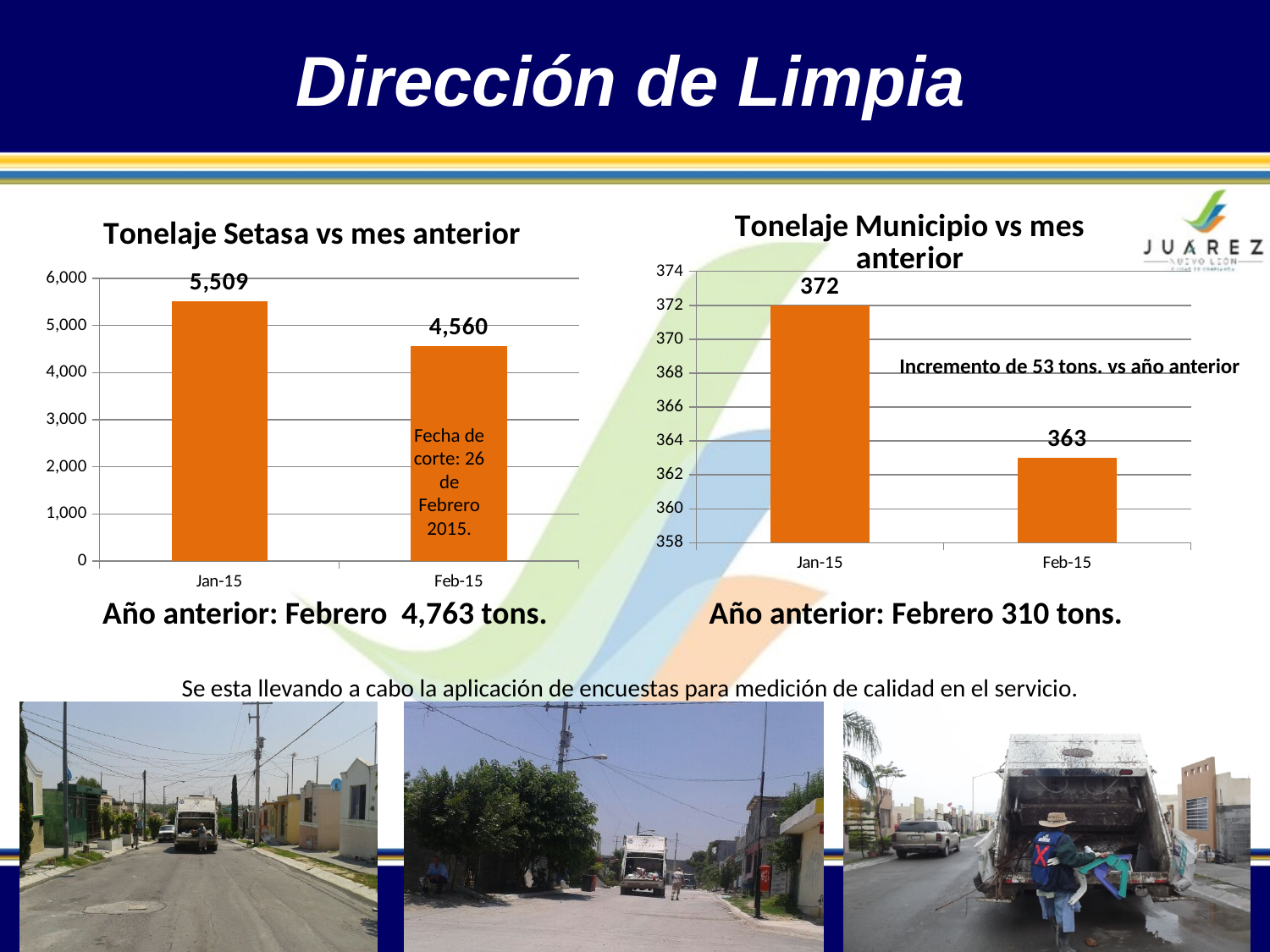
In the 'Tonelaje Municipio vs mes anterior' chart, what is the value for Jan-15? 372 What kind of chart is 'Tonelaje Municipio vs mes anterior'? Bar chart In the 'Tonelaje Municipio vs mes anterior' chart, which month has the lowest value? Feb-15 In the 'Tonelaje Municipio vs mes anterior' chart, what is the difference between the Jan-15 and Feb-15 values? 9 In the 'Tonelaje Setasa vs mes anterior' chart, what is the difference between the Jan-15 and Feb-15 values? 949 In the 'Tonelaje Setasa vs mes anterior' chart, which month has the highest value? Jan-15 How many bars are plotted in the 'Tonelaje Setasa vs mes anterior' chart? 2 In the 'Tonelaje Setasa vs mes anterior' chart, what is the value for Jan-15? 5,509 In the 'Tonelaje Setasa vs mes anterior' chart, what is the value for Feb-15? 4,560 In the 'Tonelaje Setasa vs mes anterior' chart, do the values rise or fall from Jan-15 to Feb-15? Fall In the 'Tonelaje Municipio vs mes anterior' chart, is the value for Feb-15 greater or less than 364? less In the 'Tonelaje Municipio vs mes anterior' chart, what is the value for Feb-15? 363